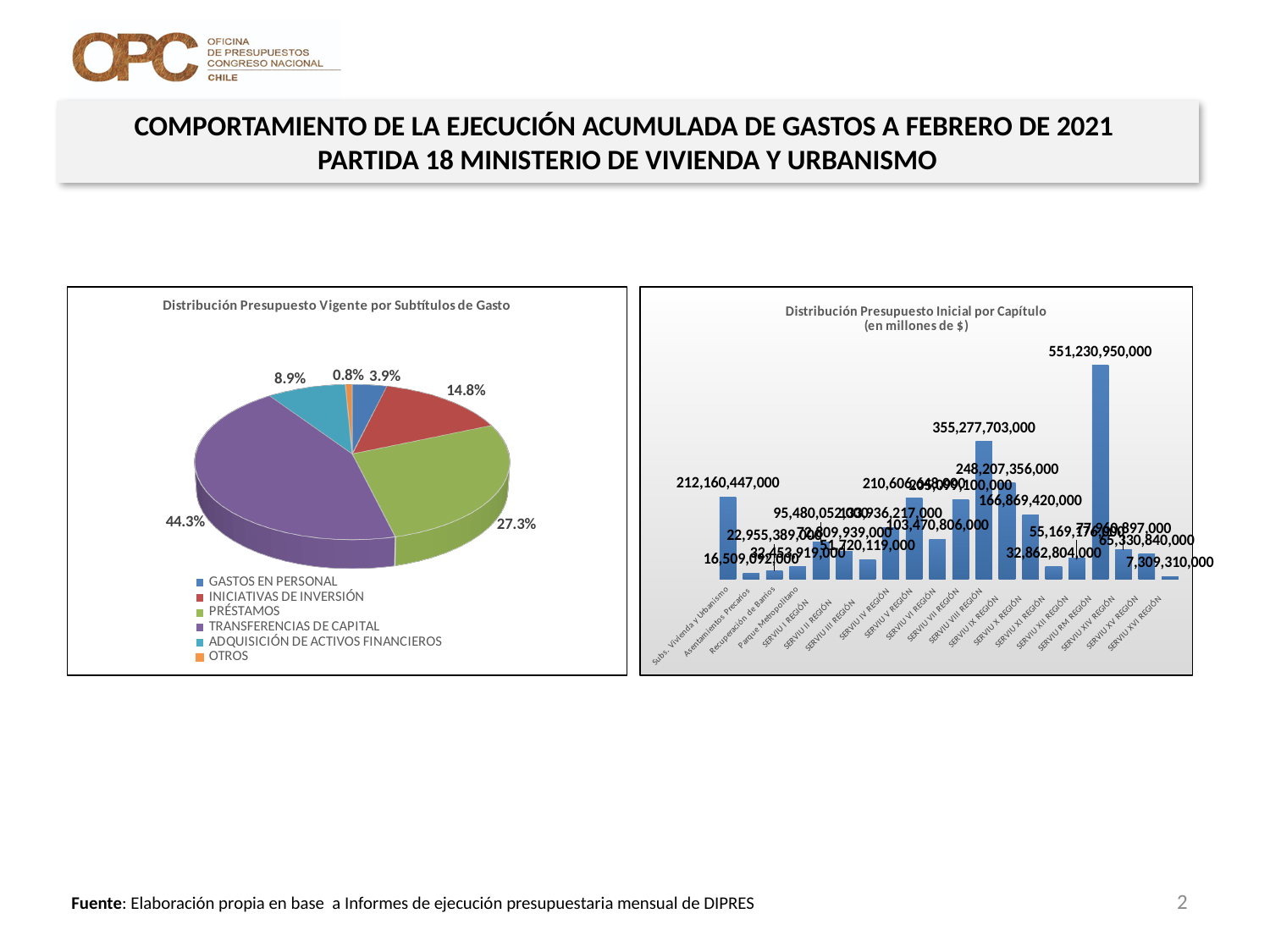
In the chart 'Distribución Presupuesto Vigente por Subtítulos de Gasto', what share does INICIATIVAS DE INVERSIÓN have? 14.8% What kind of chart is 'Distribución Presupuesto Vigente por Subtítulos de Gasto'? Pie chart In the chart 'Distribución Presupuesto Inicial por Capítulo', what is the highest value shown? 551,230,950,000 In the chart 'Distribución Presupuesto Inicial por Capítulo', what is the value for Subs. Vivienda y Urbanismo? 212,160,447,000 What kind of chart is 'Distribución Presupuesto Inicial por Capítulo'? Bar chart In the chart 'Distribución Presupuesto Vigente por Subtítulos de Gasto', which is larger: GASTOS EN PERSONAL or ADQUISICIÓN DE ACTIVOS FINANCIEROS? ADQUISICIÓN DE ACTIVOS FINANCIEROS In the chart 'Distribución Presupuesto Vigente por Subtítulos de Gasto', what share does TRANSFERENCIAS DE CAPITAL have? 44.3% In the chart 'Distribución Presupuesto Inicial por Capítulo', how many categories are shown on the x axis? 20 In the chart 'Distribución Presupuesto Inicial por Capítulo', what is the value for Asentamientos Precarios? 16,509,092,000 In the chart 'Distribución Presupuesto Vigente por Subtítulos de Gasto', how many categories does the legend list? 6 In the chart 'Distribución Presupuesto Vigente por Subtítulos de Gasto', what share does PRÉSTAMOS have? 27.3% In the chart 'Distribución Presupuesto Vigente por Subtítulos de Gasto', which category has the smallest share? OTROS